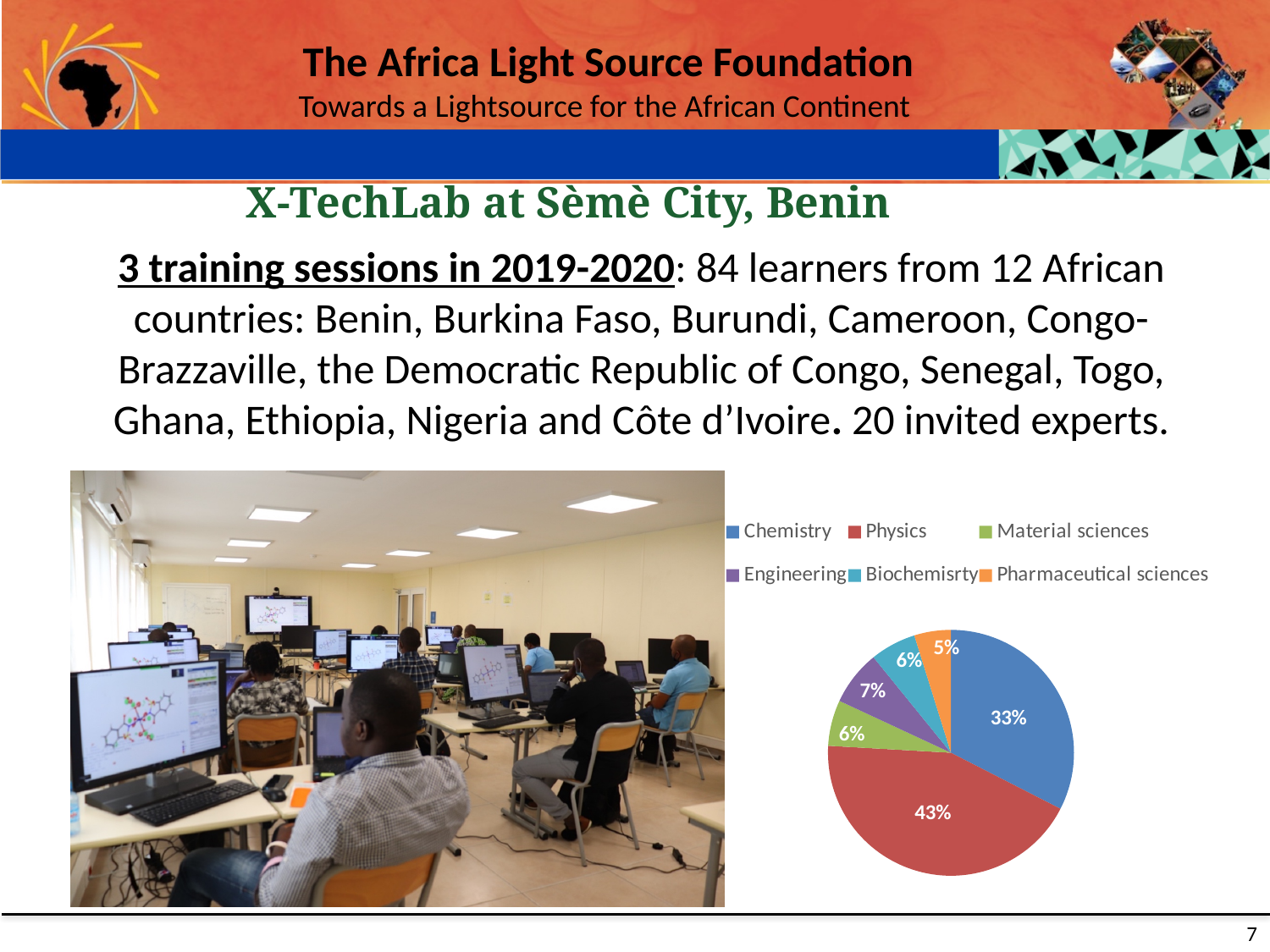
How many categories does the legend of the pie chart list? 6 What kind of chart is shown on the slide? pie chart What share of the pie chart does Engineering account for? 7% Which field has the largest slice of the pie chart? Physics What is the difference in percentage points between the Physics and Chemistry slices? 10% What share of the pie chart does Material sciences account for? 6% What colour is the Physics slice in the pie chart? red What share of the pie chart does Physics account for? 43% What share of the pie chart does Chemistry account for? 33% Which field has the smallest slice of the pie chart? Pharmaceutical sciences What share of the pie chart does Pharmaceutical sciences account for? 5% Which slice is larger, Chemistry or Engineering? Chemistry